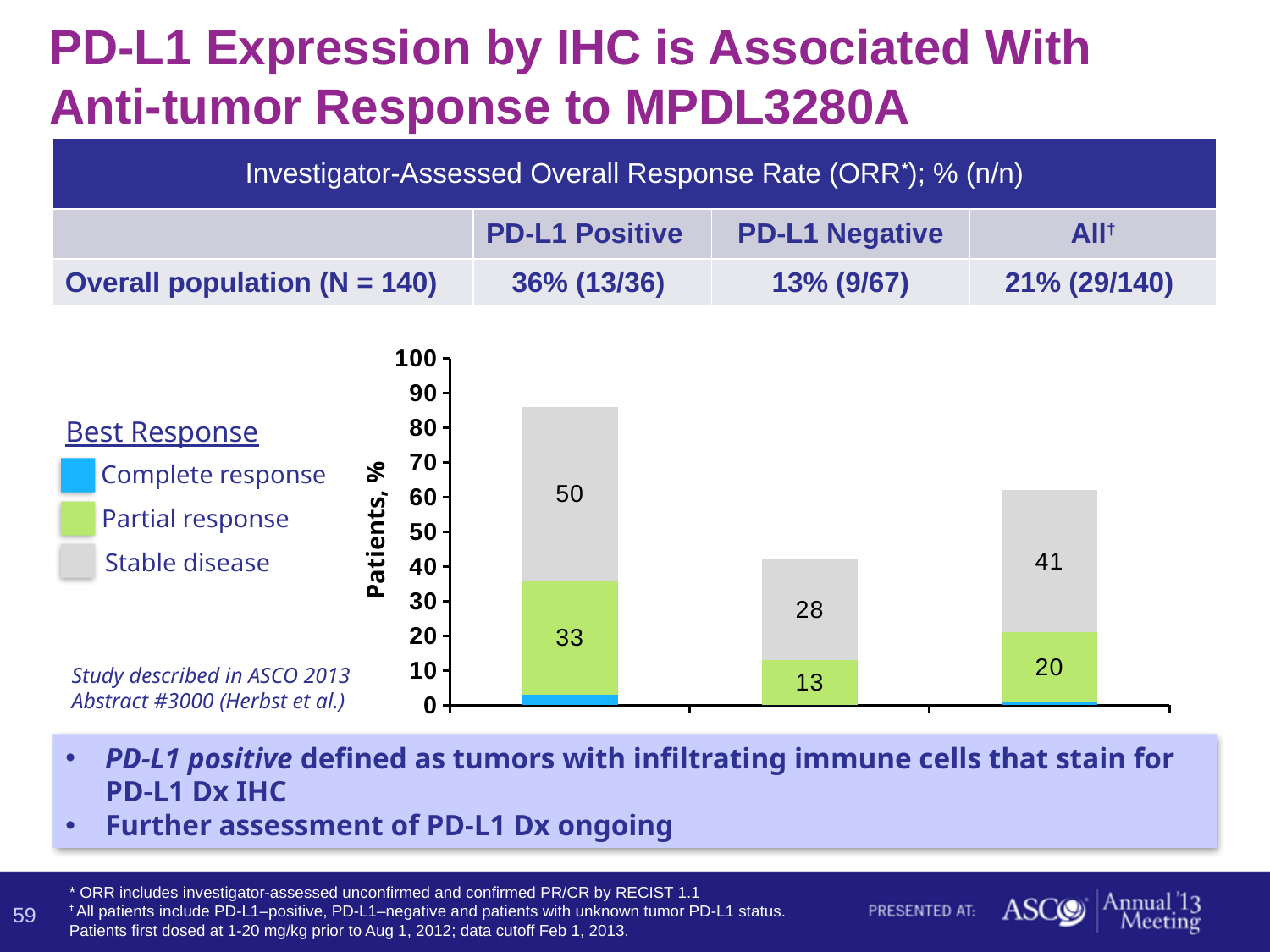
What is the label on the y axis of the chart? Patients, % What kind of chart is shown on the slide? Stacked bar chart What is the Partial response value in the leftmost bar? 33 What is the Partial response value in the middle bar? 13 How many series does the Best Response legend list? 3 How many stacked bars are plotted in the chart? 3 What is the Stable disease value in the rightmost bar? 41 Which bar has the larger Stable disease value, the leftmost bar or the rightmost bar? Leftmost bar Which bar has the lowest Partial response value? Middle bar What is the Stable disease value in the leftmost bar? 50 What is the difference between the Partial response values of the leftmost bar and the middle bar? 20 Is the total height of the middle bar greater or less than 50? less